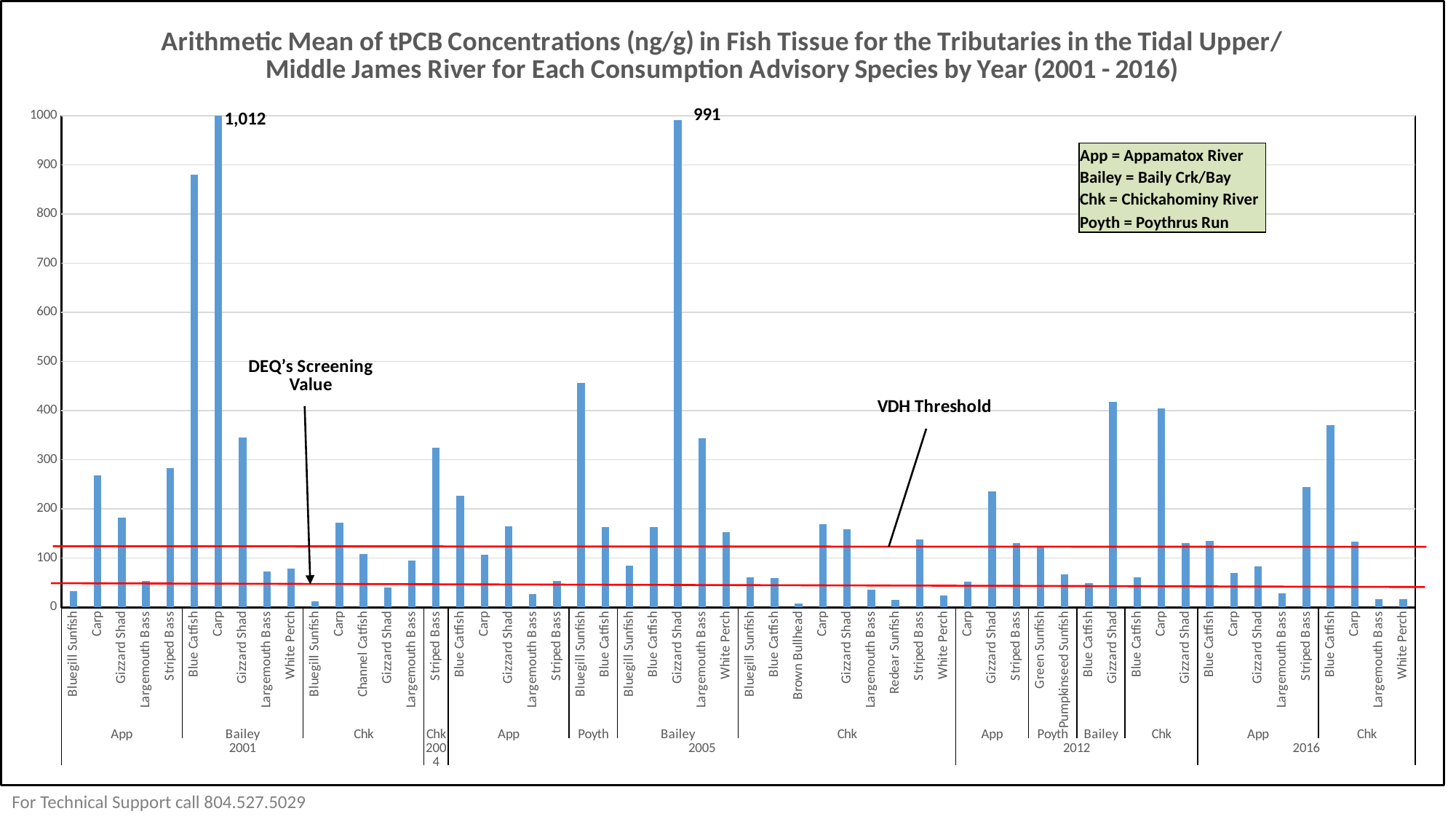
Is the value for Blue Catfish in Bailey 2001 greater or less than 800? greater According to the key box on the chart, what does 'Chk' stand for? Chickahominy River What are the two red horizontal lines on the chart labelled? DEQ's Screening Value and VDH Threshold What is the difference between the two labelled values, 1,012 and 991? 21 Which species and location has the highest tPCB concentration on the chart? Carp, Bailey (2001) Which is larger: the value for Carp in Bailey 2001 or the value for Gizzard Shad in Bailey 2005? Carp in Bailey 2001 What kind of chart is shown on the slide? bar chart What is the labelled value for Gizzard Shad in Bailey in 2005? 991 Is the value for Blue Catfish in Chk 2016 greater or less than 400? less What is the labelled value for Carp in Bailey in 2001? 1,012 Is the value for Striped Bass in Chk 2004 greater or less than 300? greater